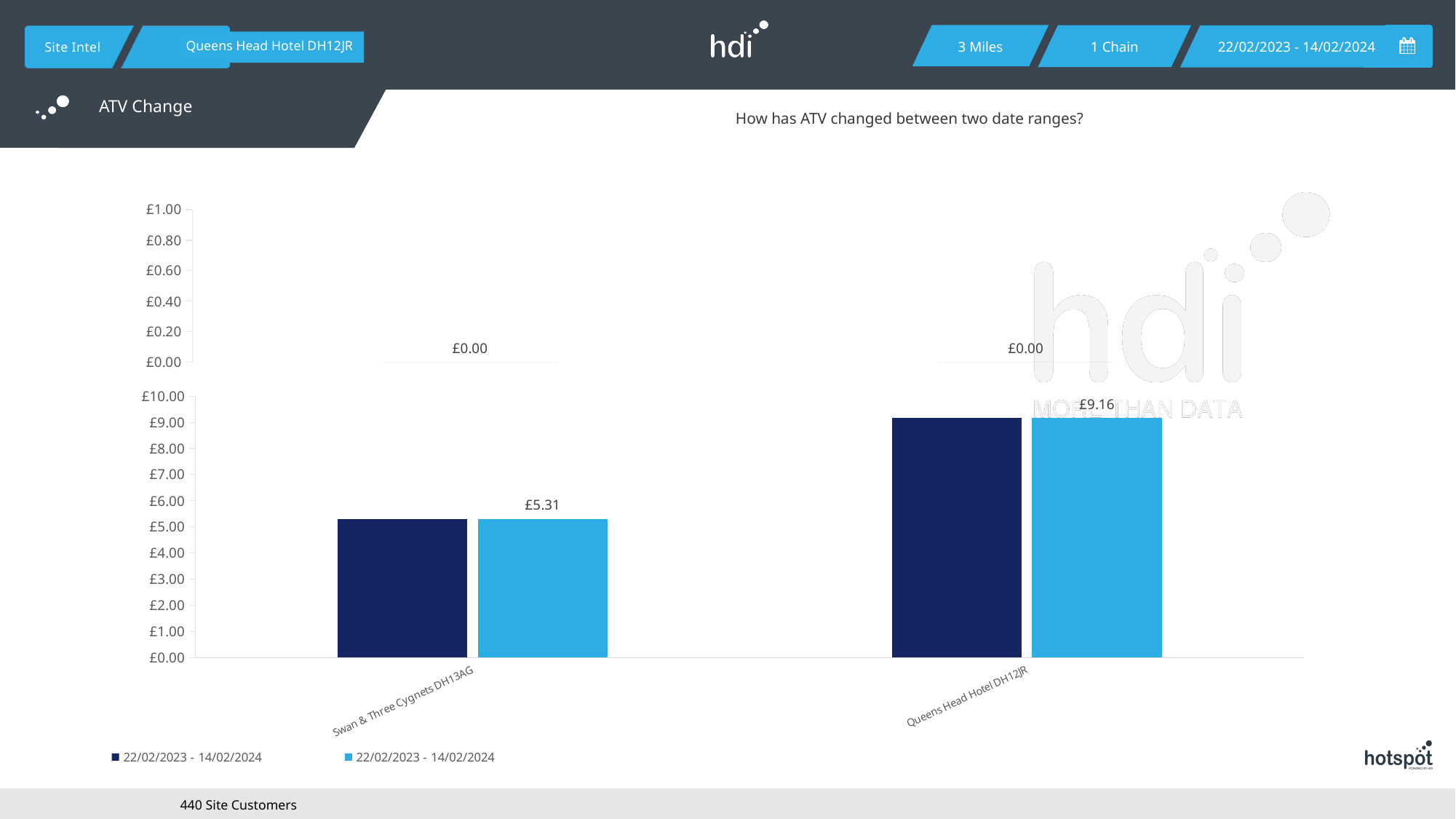
In the lower chart, what is the labelled value of the light blue bar for Queens Head Hotel DH12JR? £9.16 In the lower chart, which site has the higher labelled light blue value? Queens Head Hotel DH12JR In the lower chart, which site has the lower labelled light blue value? Swan & Three Cygnets DH13AG What kind of chart is the lower chart on the slide? bar chart How many sites (categories) are shown on the x axis of the lower chart? 2 What question is written as the heading above the charts? How has ATV changed between two date ranges? In the lower chart, what is the labelled value of the light blue bar for Swan & Three Cygnets DH13AG? £5.31 In the lower chart, is the dark blue bar for Swan & Three Cygnets DH13AG greater or less than £6.00? less How many series does the legend of the lower chart list? 2 In the lower chart, is the dark blue bar for Queens Head Hotel DH12JR greater or less than £8.00? greater In the lower chart, what is the difference between the labelled light blue values for Queens Head Hotel DH12JR and Swan & Three Cygnets DH13AG? £3.85 In the upper chart, what value is labelled for Swan & Three Cygnets DH13AG? £0.00